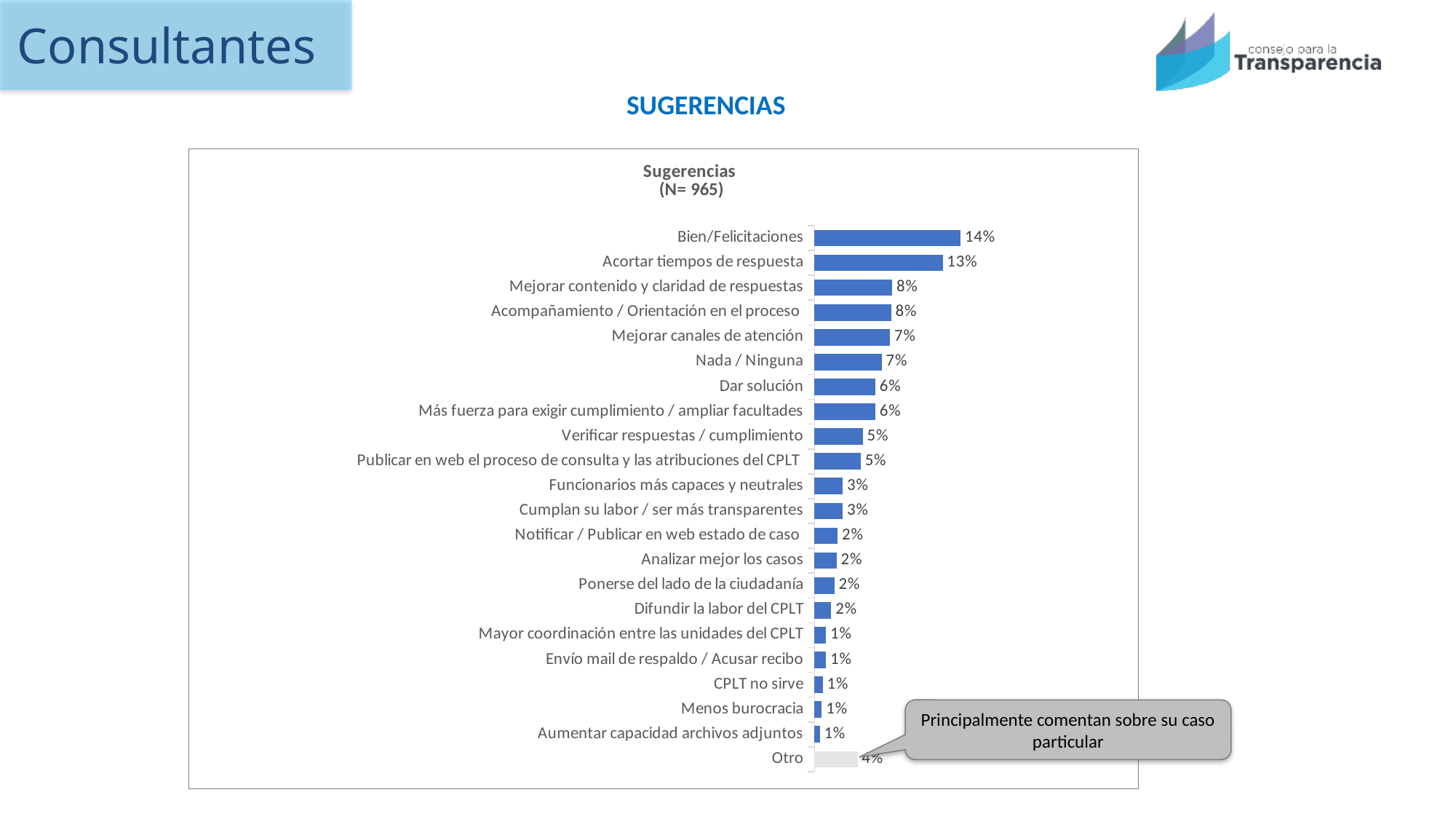
How many categories are shown in the chart? 22 What is the difference between Mejorar contenido y claridad de respuestas and Dar solución? 2% Which is larger, Mejorar canales de atención or Verificar respuestas / cumplimiento? Mejorar canales de atención Which category has the highest value? Bien/Felicitaciones What is the value for Nada / Ninguna? 7% What kind of chart is this? Bar chart What is the value for Bien/Felicitaciones? 14% What is the value for Funcionarios más capaces y neutrales? 3% What is the difference between Bien/Felicitaciones and Acortar tiempos de respuesta? 1% What is the sample size (N) shown in the chart title? 965 What is the title of the chart? Sugerencias (N= 965) What is the value for Acortar tiempos de respuesta? 13%